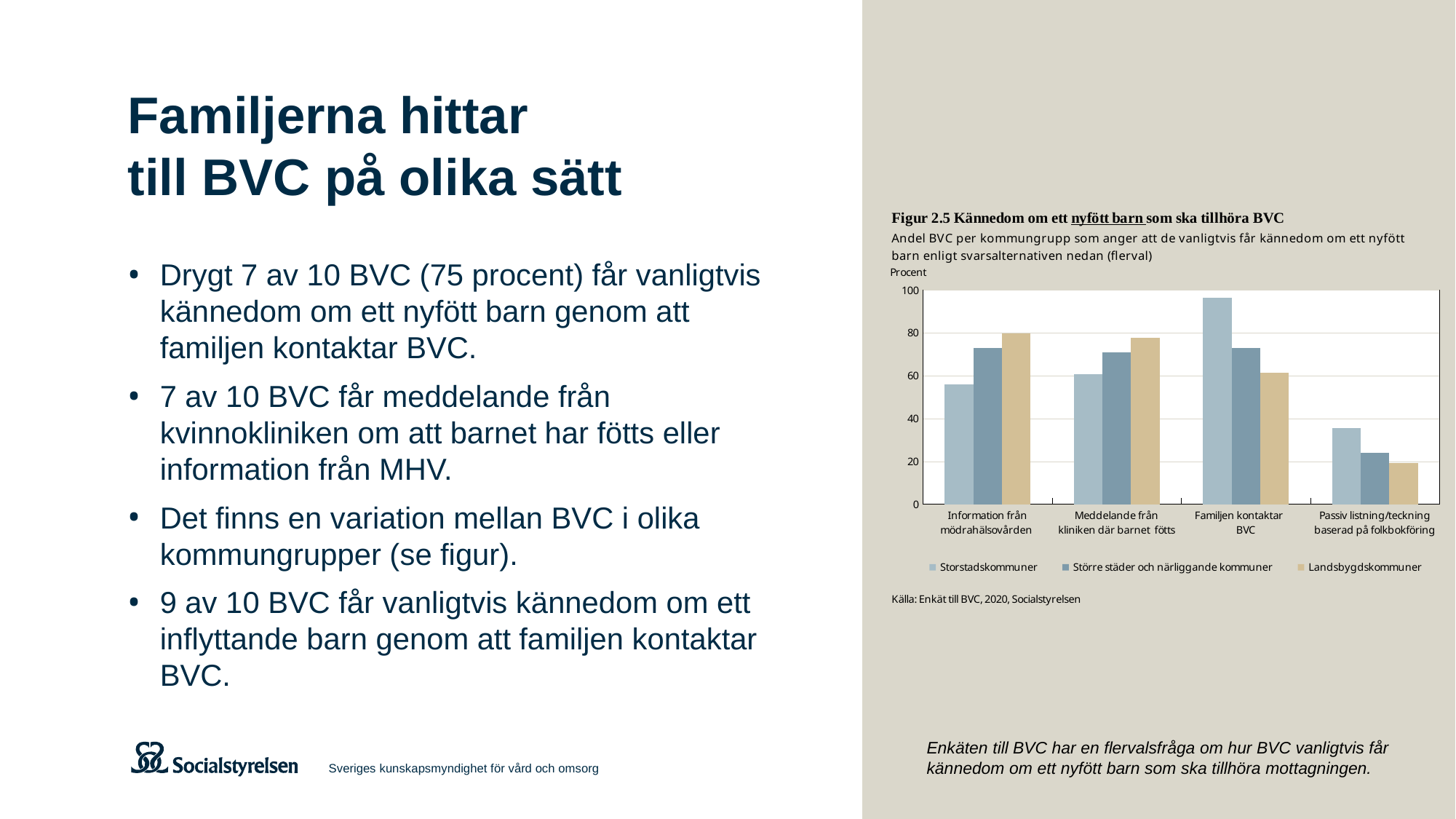
For Familjen kontaktar BVC, which is larger: Storstadskommuner or Landsbygdskommuner? Storstadskommuner What kind of chart is shown on the slide? Bar chart Is the Storstadskommuner value for Familjen kontaktar BVC greater or less than 80? greater What is the figure number and title of the chart? Figur 2.5 Kännedom om ett nyfött barn som ska tillhöra BVC For which category is the Landsbygdskommuner bar lowest? Passiv listning/teckning baserad på folkbokföring For which category is the Storstadskommuner bar highest? Familjen kontaktar BVC Is the Landsbygdskommuner value for Passiv listning/teckning baserad på folkbokföring greater or less than 40? less Is the Större städer och närliggande kommuner value for Passiv listning/teckning baserad på folkbokföring greater or less than 40? less How many series does the chart's legend list? 3 What source is cited below the chart? Källa: Enkät till BVC, 2020, Socialstyrelsen For Information från mödrahälsovården, which is larger: Storstadskommuner or Landsbygdskommuner? Landsbygdskommuner How many categories are shown on the x axis of the chart? 4